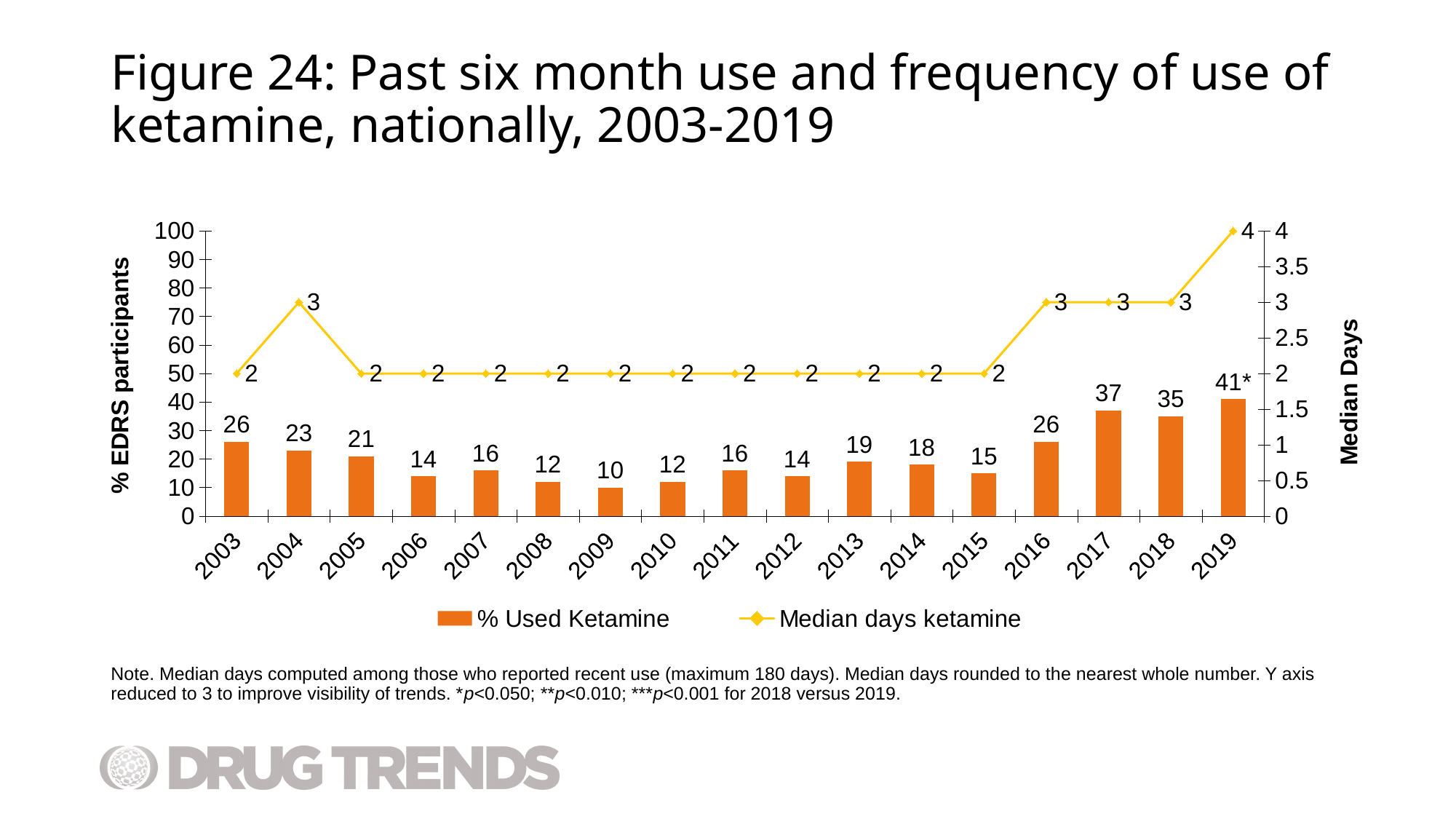
How many series does the legend list? 2 What is the value of % Used Ketamine in 2017? 37 Which year has the highest % Used Ketamine value? 2019 How many years are shown on the x axis? 17 What is the label of the right-hand y axis? Median Days Which year has the lowest % Used Ketamine value? 2009 Which is larger, the % Used Ketamine value for 2003 or for 2005? 2003 What kind of chart is used for the % Used Ketamine series? Bar chart What is the difference between the % Used Ketamine values for 2017 and 2018? 2 What is the Median days ketamine value for 2004? 3 What is the Median days ketamine value in 2019? 4 Does the Median days ketamine series rise or fall from 2015 to 2019? Rise